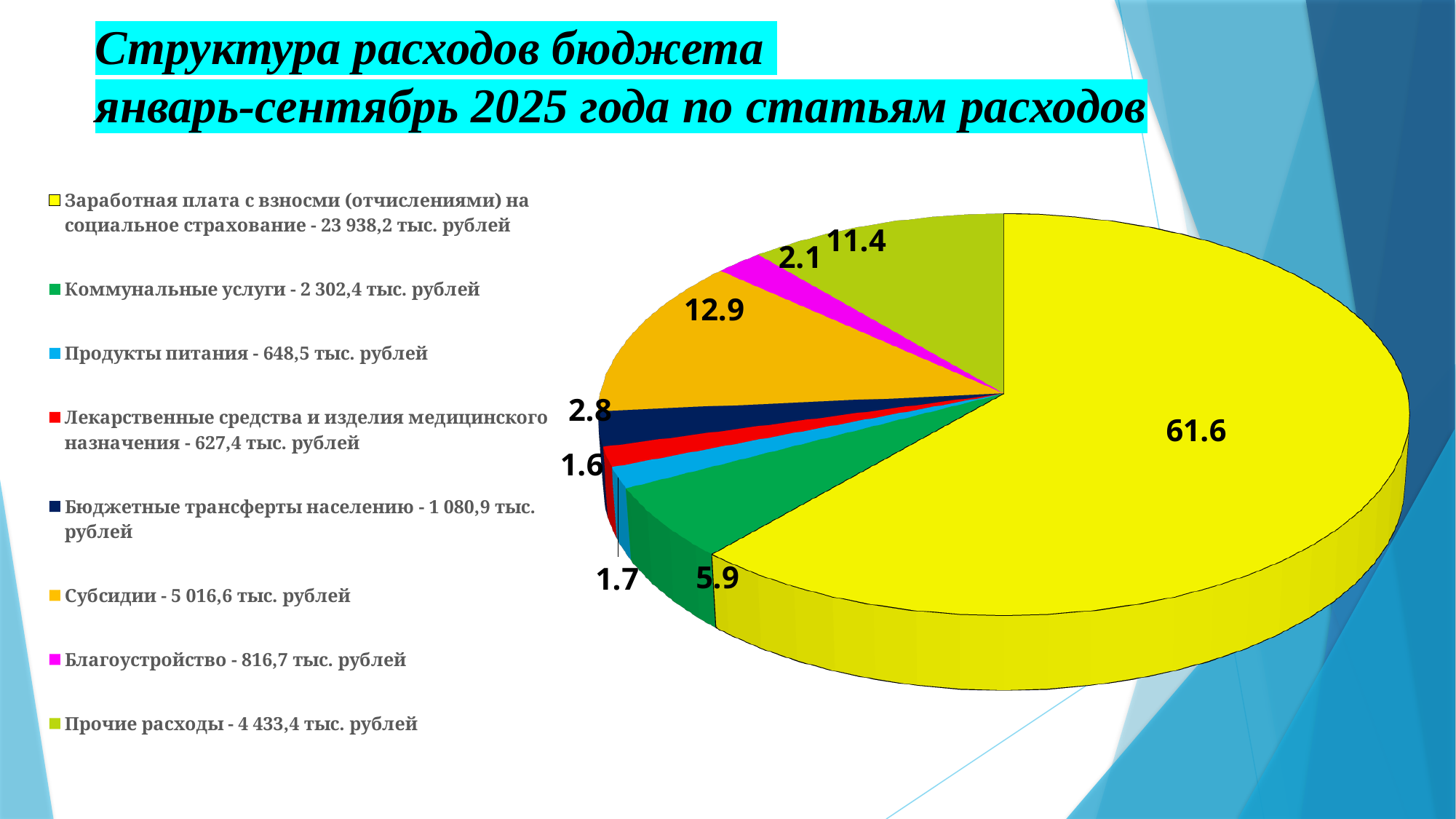
What value is shown for the slice 'Субсидии'? 12.9 Which category has the largest slice of the pie? Заработная плата с взносми (отчислениями) на социальное страхование What value is shown for the slice 'Бюджетные трансферты населению'? 2.8 How many slices does the pie chart have? 8 Which is larger, the slice for 'Благоустройство' or the slice for 'Бюджетные трансферты населению'? Бюджетные трансферты населению According to the legend, what amount in thousand rubles is given for 'Продукты питания'? 648,5 тыс. рублей What value is shown for the slice 'Заработная плата с взносми (отчислениями) на социальное страхование'? 61.6 What value is shown for the slice 'Прочие расходы'? 11.4 What value is shown for the slice 'Коммунальные услуги'? 5.9 Which category has the smallest slice of the pie? Лекарственные средства и изделия медицинского назначения What kind of chart is shown on the slide? Pie chart What is the difference between the values for 'Субсидии' and 'Прочие расходы'? 1.5